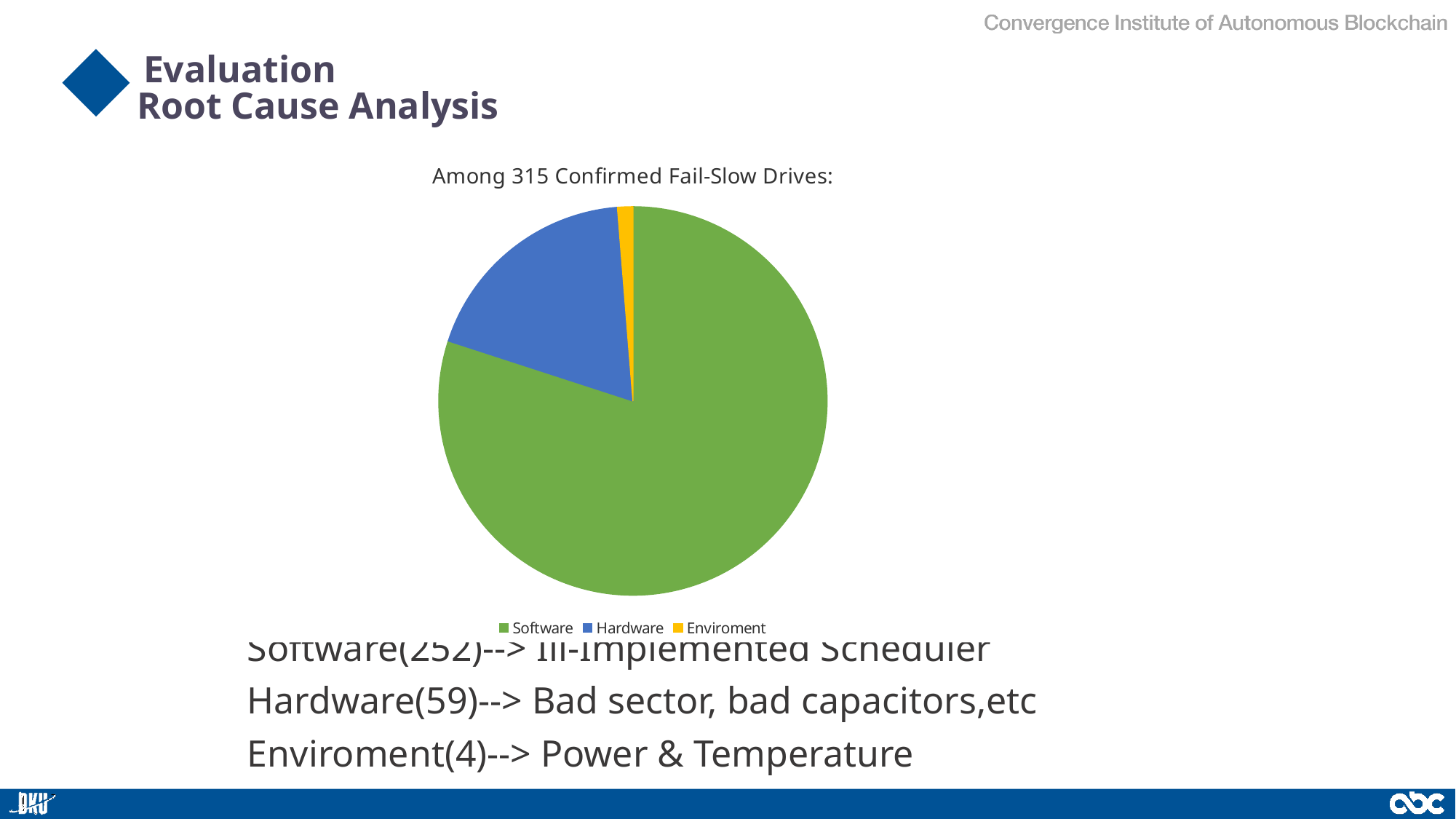
How many of the confirmed fail-slow drives are attributed to Hardware? 59 What is the title of the pie chart? Among 315 Confirmed Fail-Slow Drives: How many of the confirmed fail-slow drives are attributed to Software? 252 What colour is the Hardware slice in the pie chart? blue Which category has the largest slice of the pie chart? Software Which category has the smallest slice of the pie chart? Enviroment Which slice is larger, Hardware or Enviroment? Hardware What share of the 315 confirmed fail-slow drives does the Software slice represent? 80% What is the difference between the Software count and the Hardware count? 193 What kind of chart is shown on the slide? pie chart How many categories does the pie chart's legend list? 3 How many of the confirmed fail-slow drives are attributed to Enviroment? 4